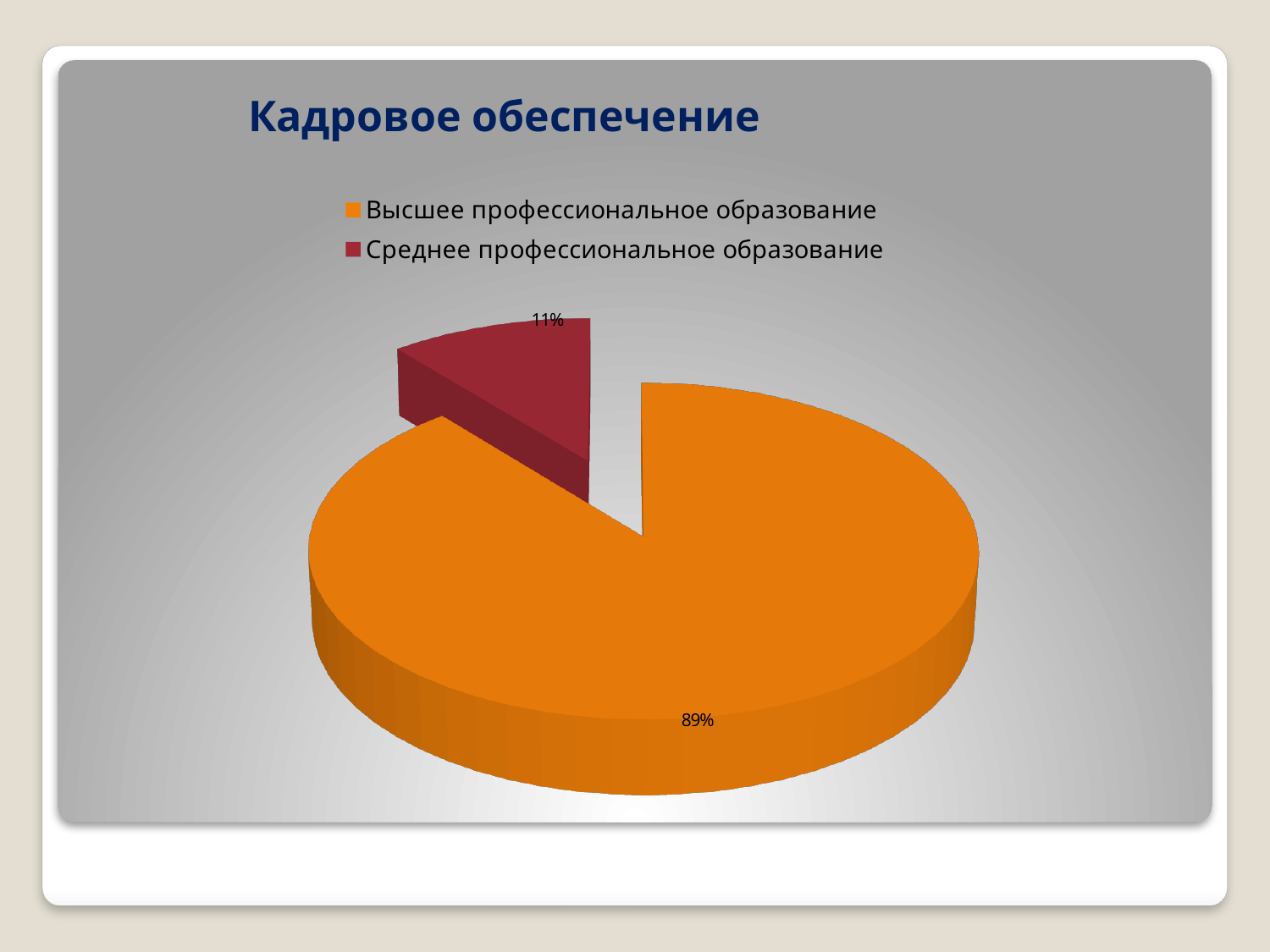
What share of the pie does Высшее профессиональное образование have? 89% Which is larger: the share for Высшее профессиональное образование or for Среднее профессиональное образование? Высшее профессиональное образование What is the difference in percentage points between Высшее профессиональное образование and Среднее профессиональное образование? 78 How many categories does the pie chart show? 2 What is the title of the slide? Кадровое обеспечение What type of chart is shown on the slide? Pie chart What colour is the slice for Среднее профессиональное образование? Dark red Which category has the largest slice of the pie? Высшее профессиональное образование How many entries does the legend list? 2 What share of the pie does Среднее профессиональное образование have? 11% Which category has the smallest slice of the pie? Среднее профессиональное образование